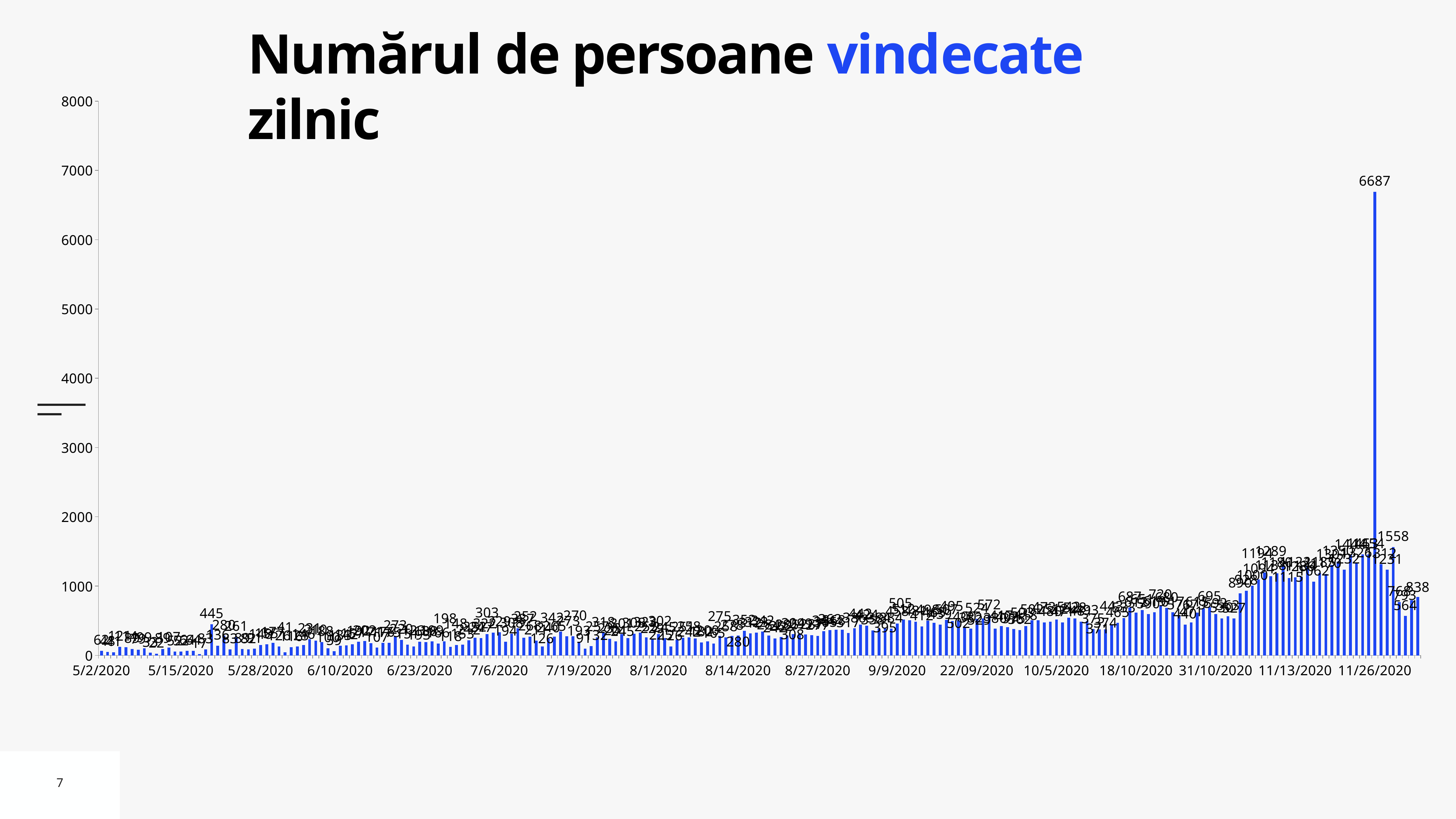
Is the value for 5/28/2020 greater or less than 2000? less What kind of chart is shown on the slide? bar chart Is the tallest bar on the chart greater or less than 6000? greater Do the daily values generally rise or fall from May 2020 to November 2020? rise What is the difference between the bar labelled 6687 and the bar labelled 1558? 5129 Is the value for the last bar on the chart (labelled 838) greater or less than 1000? less Which is larger: the bar labelled 6687 or the bar labelled 1558? 6687 What is the highest value labelled on the chart? 6687 What is the highest tick value shown on the vertical axis? 8000 What is the title of the chart? Numărul de persoane vindecate zilnic